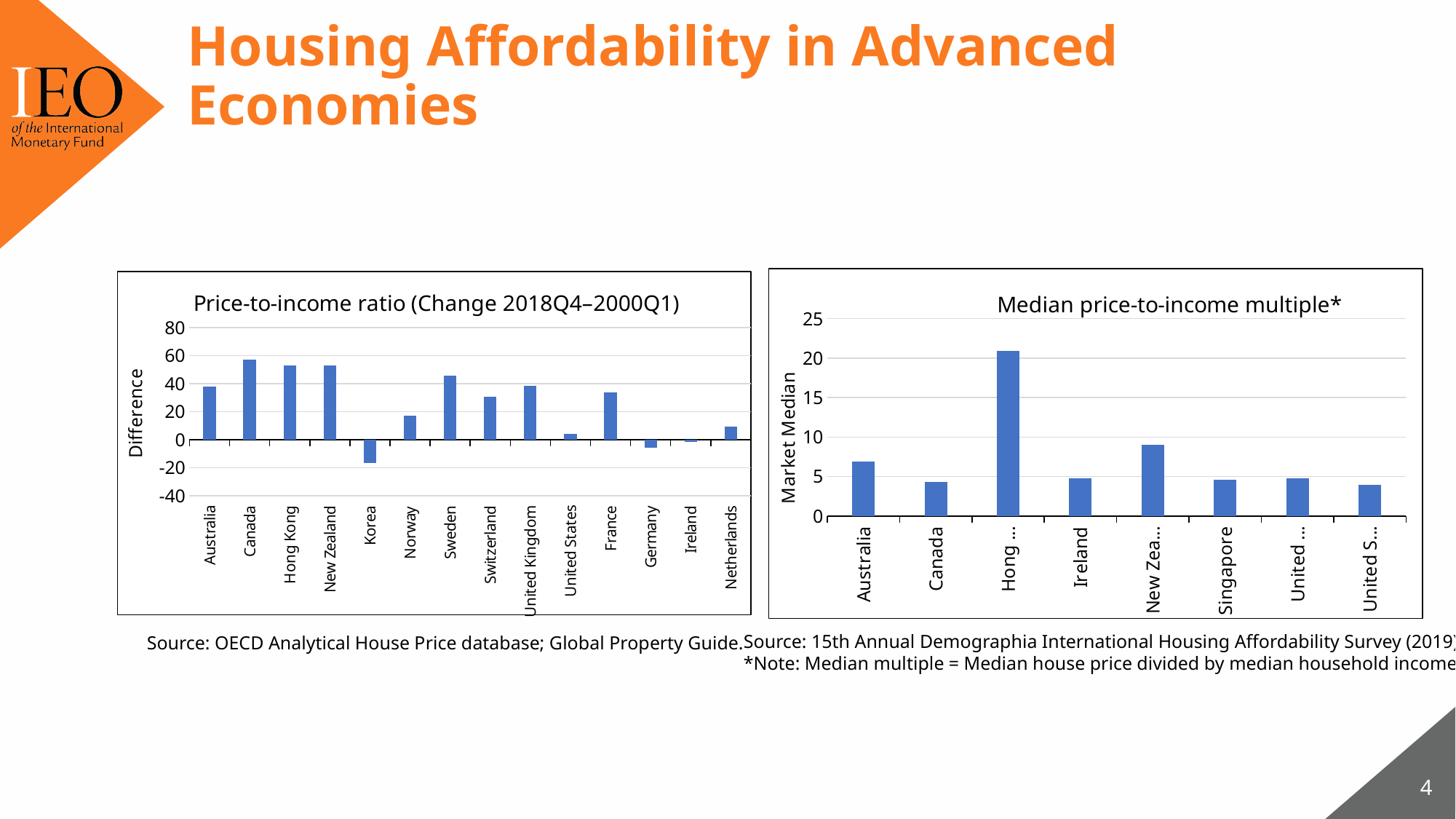
In the 'Price-to-income ratio (Change 2018Q4–2000Q1)' chart, is the value for Korea greater or less than 0? less In the 'Median price-to-income multiple*' chart, is the value for Australia greater or less than 5? greater In the 'Price-to-income ratio (Change 2018Q4–2000Q1)' chart, which country has the lowest value? Korea In the 'Price-to-income ratio (Change 2018Q4–2000Q1)' chart, which country has the highest value? Canada How many countries are shown in the 'Median price-to-income multiple*' chart? 8 What kind of chart is the 'Price-to-income ratio (Change 2018Q4–2000Q1)' chart? bar chart In the 'Price-to-income ratio (Change 2018Q4–2000Q1)' chart, is the value for Australia greater or less than 20? greater In the 'Median price-to-income multiple*' chart, which is larger, the value for Australia or the value for Canada? Australia How many countries are shown in the 'Price-to-income ratio (Change 2018Q4–2000Q1)' chart? 14 In the 'Price-to-income ratio (Change 2018Q4–2000Q1)' chart, which is larger, the value for Canada or the value for United States? Canada What is the y-axis label of the 'Price-to-income ratio (Change 2018Q4–2000Q1)' chart? Difference